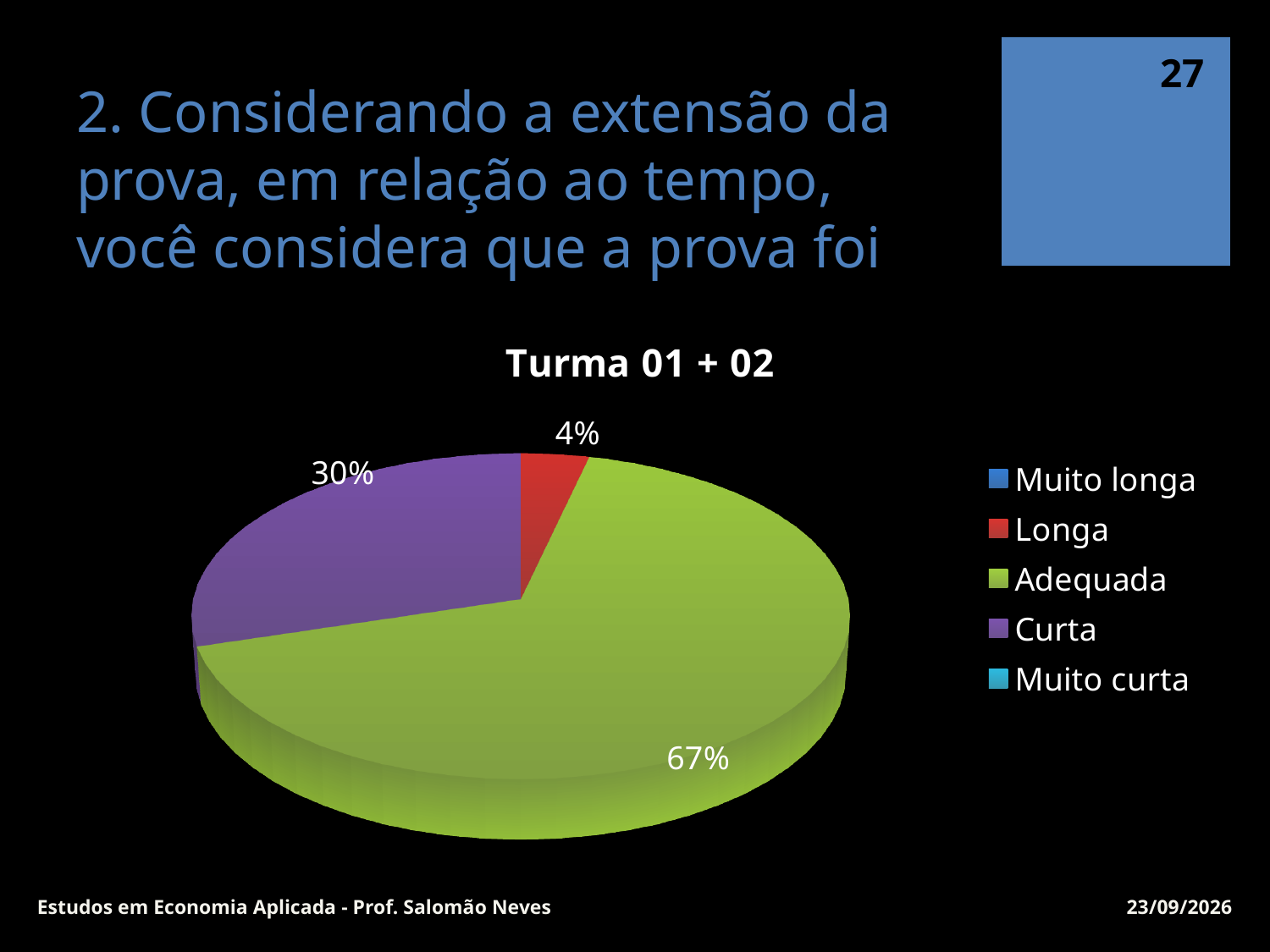
How many slices of the pie have a percentage label printed? 3 What is the difference in percentage points between the Curta slice and the Longa slice? 26% What percentage of the pie is labelled for Adequada? 67% What kind of chart is shown on the slide? pie chart Among the slices with a printed percentage, which category has the smallest slice? Longa Which slice is larger, Curta or Longa? Curta What is the title of the chart? Turma 01 + 02 What is the difference in percentage points between the Adequada slice and the Curta slice? 37% What percentage of the pie is labelled for Longa? 4% What percentage of the pie is labelled for Curta? 30% Which category has the largest slice of the pie? Adequada How many entries does the chart legend list? 5